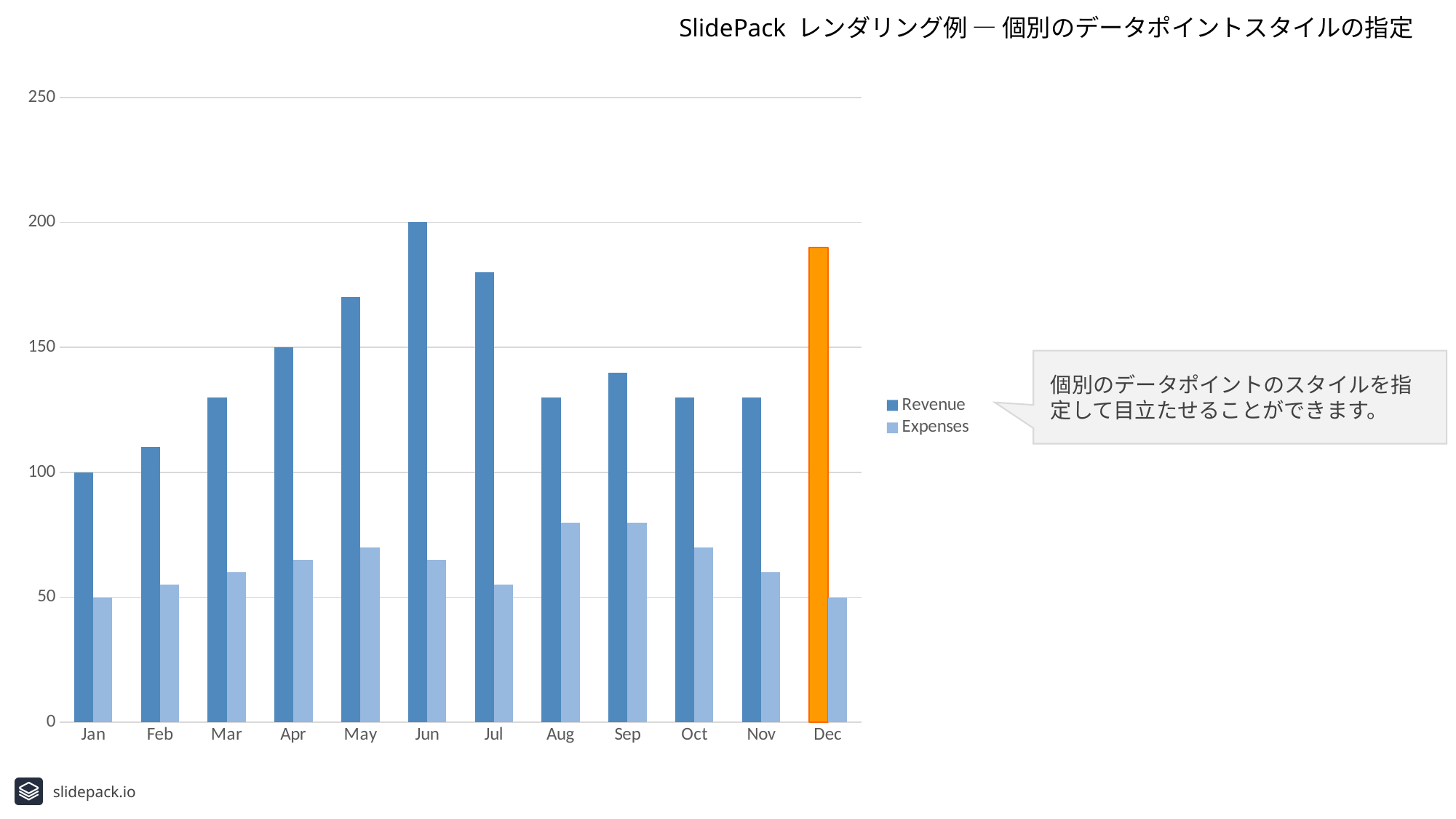
How many months are shown on the x axis? 12 Which month has the lowest Revenue? Jan Which is larger, Revenue for Jul or Revenue for Aug? Jul What type of chart is shown on the slide? bar chart What is the Expenses value for Jan? 50 Is the Revenue value for Dec greater or less than 150? greater What is the Revenue value for Jan? 100 How many series does the legend list? 2 Which month's Revenue bar is highlighted in orange? Dec Which month has the highest Revenue? Jun What is the Revenue value for Apr? 150 What is the Revenue value for Jun? 200